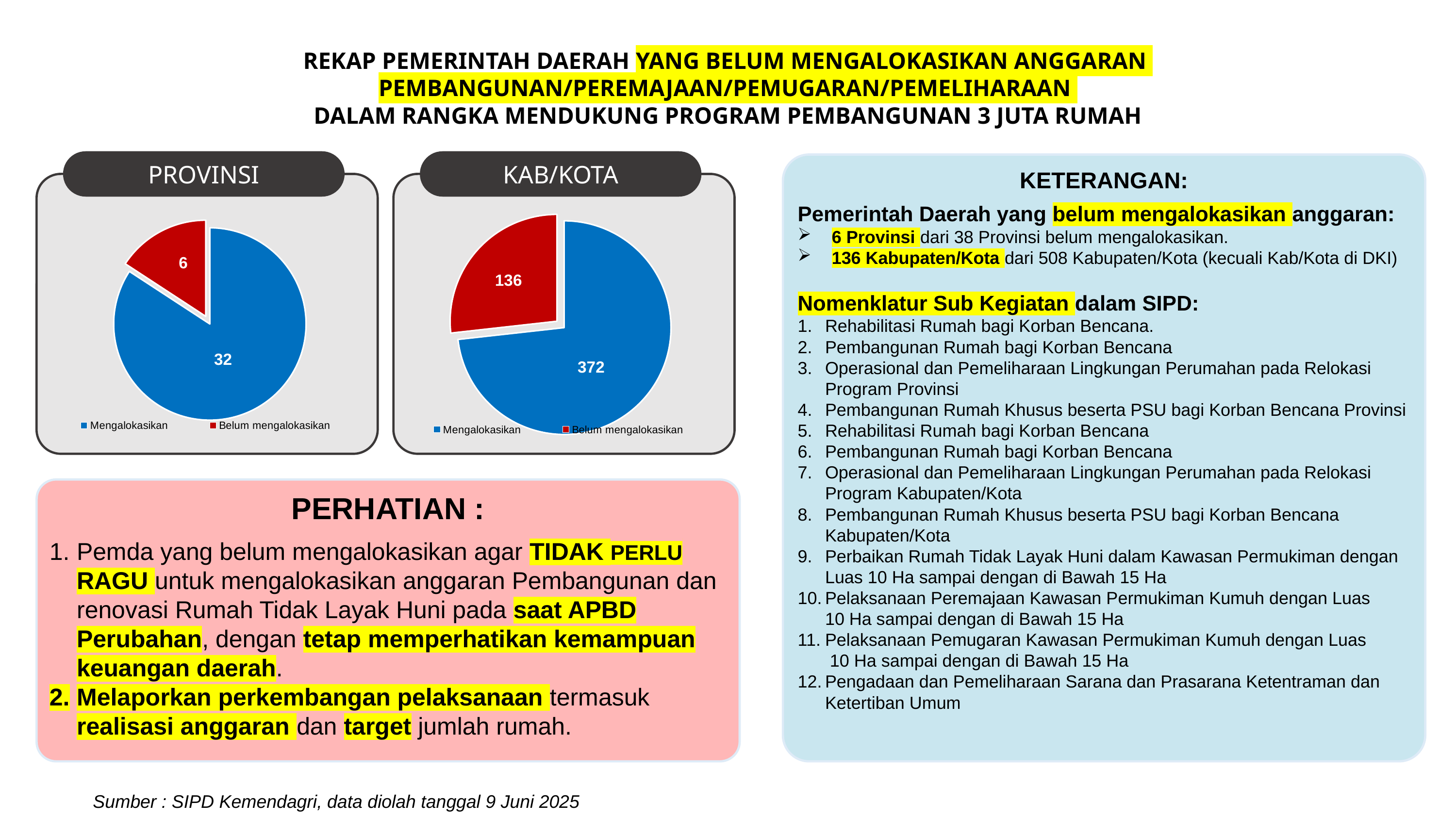
In the KAB/KOTA chart, what is the difference between Mengalokasikan and Belum mengalokasikan? 236 In the PROVINSI chart, what is the value for Belum mengalokasikan? 6 How many slices does the KAB/KOTA pie chart have? 2 What kind of chart is the PROVINSI chart? Pie chart In the PROVINSI chart, what is the value for Mengalokasikan? 32 In the PROVINSI chart, which category has the smallest slice? Belum mengalokasikan In the PROVINSI chart, what is the difference between Mengalokasikan and Belum mengalokasikan? 26 In the KAB/KOTA chart, which category has the largest slice? Mengalokasikan In the KAB/KOTA chart, what is the value for Mengalokasikan? 372 In the KAB/KOTA chart, what is the value for Belum mengalokasikan? 136 In the KAB/KOTA chart, what colour is the Belum mengalokasikan slice? Red